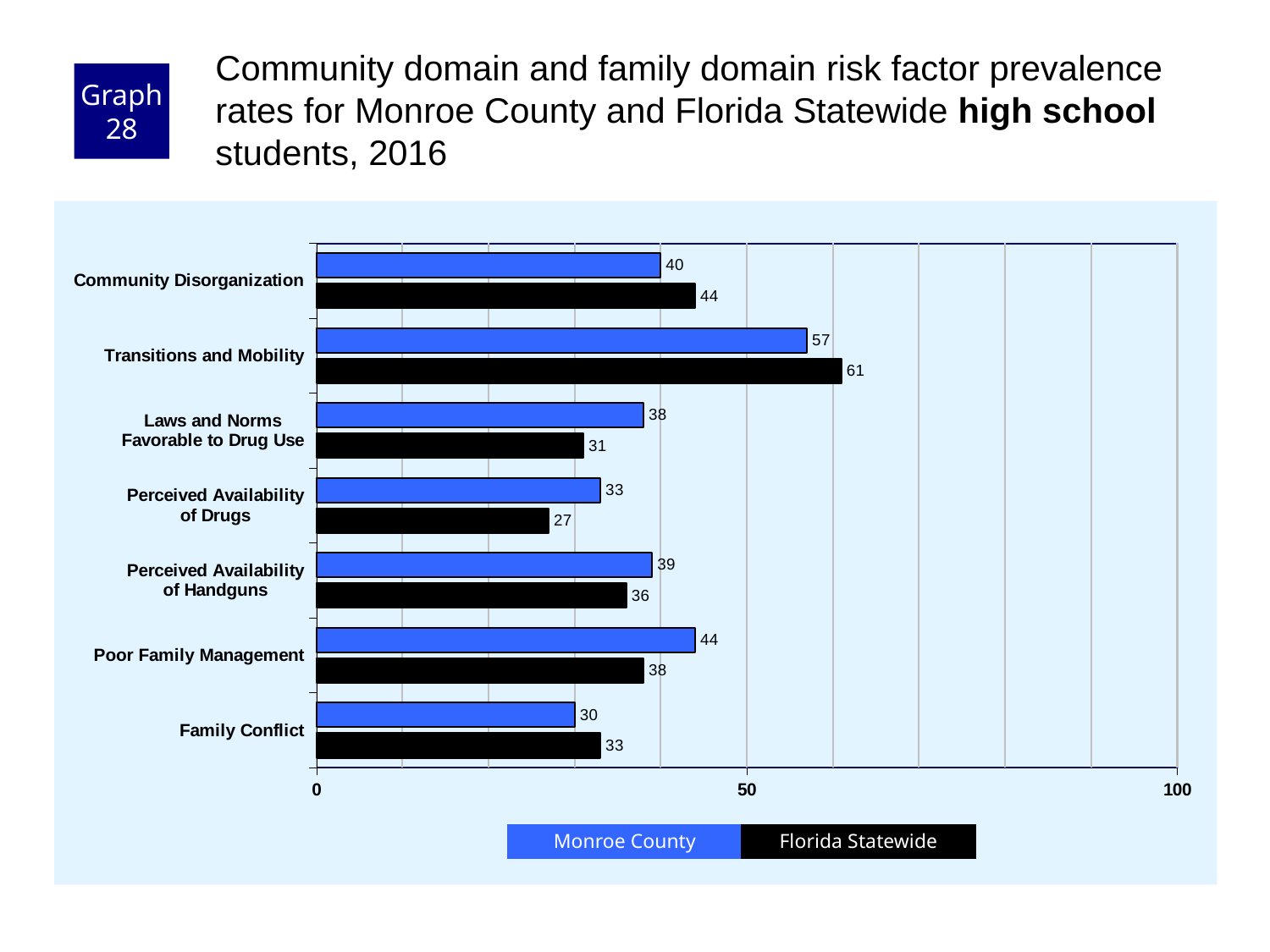
What is the Florida Statewide value for Perceived Availability of Drugs? 27 For Poor Family Management, which is larger: the Monroe County value or the Florida Statewide value? Monroe County Which risk factor has the lowest Monroe County value? Family Conflict How many risk factor categories are shown on the chart? 7 How many series does the legend list? 2 What is the Florida Statewide value for Community Disorganization? 44 What is the Monroe County value for Transitions and Mobility? 57 Is the Florida Statewide value for Transitions and Mobility greater or less than 50? greater What is the difference between the Florida Statewide and Monroe County values for Transitions and Mobility? 4 What kind of chart is shown on the slide? Bar chart What is the difference between the Monroe County and Florida Statewide values for Laws and Norms Favorable to Drug Use? 7 Which risk factor has the highest Florida Statewide value? Transitions and Mobility